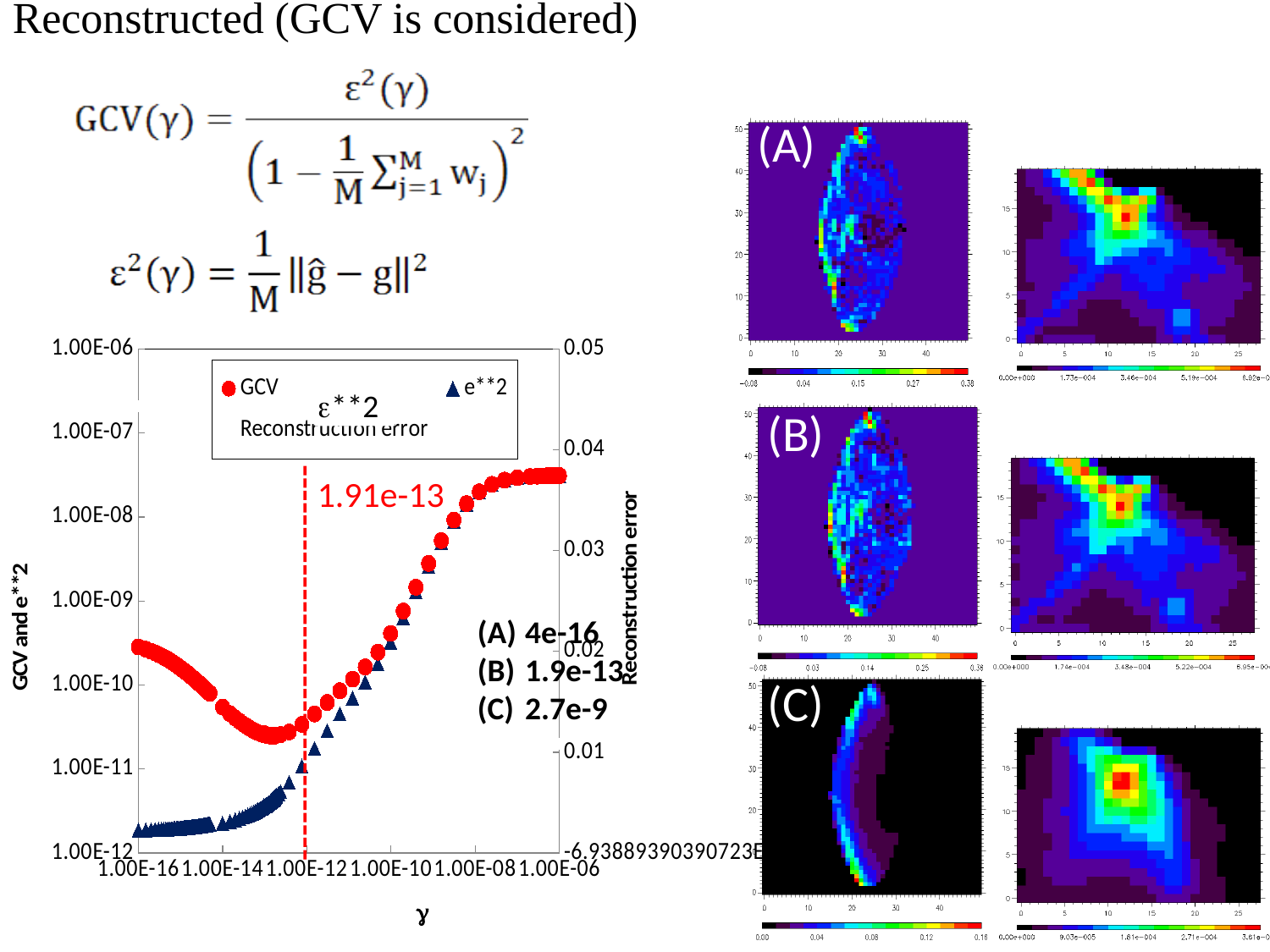
Is the GCV value at γ = 1.00E-06 greater or less than 1.00E-08? greater What is the highest tick value shown on the right-hand (Reconstruction error) axis? 0.05 Is the GCV value at γ = 1.00E-16 greater or less than 1.00E-10? greater What kind of chart is shown on the left of the slide? scatter chart Do the e**2 values rise or fall as γ increases along the x axis? rise What γ value is written next to the red dashed vertical line in the chart? 1.91e-13 How many series does the legend of the chart list? 3 What is the label of the x axis of the chart? γ Do the GCV values rise or fall as γ increases from 1.00E-10 to 1.00E-06? rise At γ = 1.00E-16, which series has the higher value, GCV or e**2? GCV Is the e**2 value at γ = 1.00E-16 greater or less than 1.00E-11? less